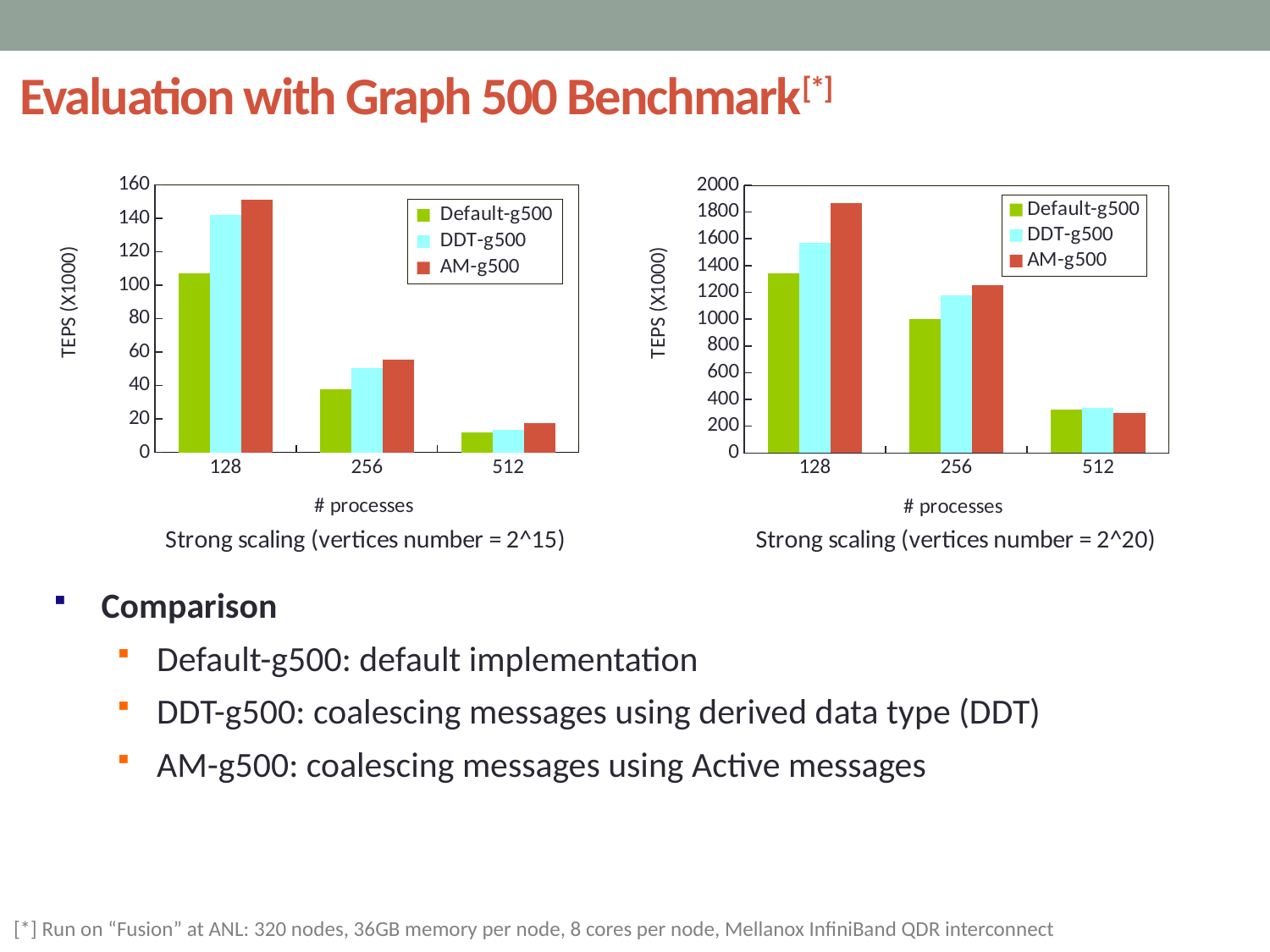
In the chart titled 'Strong scaling (vertices number = 2^15)', at 128 processes, which is larger: AM-g500 or Default-g500? AM-g500 In the chart titled 'Strong scaling (vertices number = 2^20)', is the Default-g500 value at 256 processes greater or less than 1200? less In the chart titled 'Strong scaling (vertices number = 2^15)', how many process counts are shown on the x axis? 3 In the chart titled 'Strong scaling (vertices number = 2^20)', at 128 processes, which is larger: DDT-g500 or Default-g500? DDT-g500 In the chart titled 'Strong scaling (vertices number = 2^15)', at which number of processes is the AM-g500 value highest? 128 In the chart titled 'Strong scaling (vertices number = 2^15)', is the DDT-g500 value at 256 processes greater or less than 60? less In the chart titled 'Strong scaling (vertices number = 2^20)', what is the label on the y axis? TEPS (X1000) In the chart titled 'Strong scaling (vertices number = 2^20)', is the AM-g500 value at 128 processes greater or less than 1800? greater In the chart titled 'Strong scaling (vertices number = 2^15)', what kind of chart is shown? bar chart In the chart titled 'Strong scaling (vertices number = 2^15)', how many series does the legend list? 3 In the chart titled 'Strong scaling (vertices number = 2^15)', do the Default-g500 values rise or fall as the number of processes increases? fall